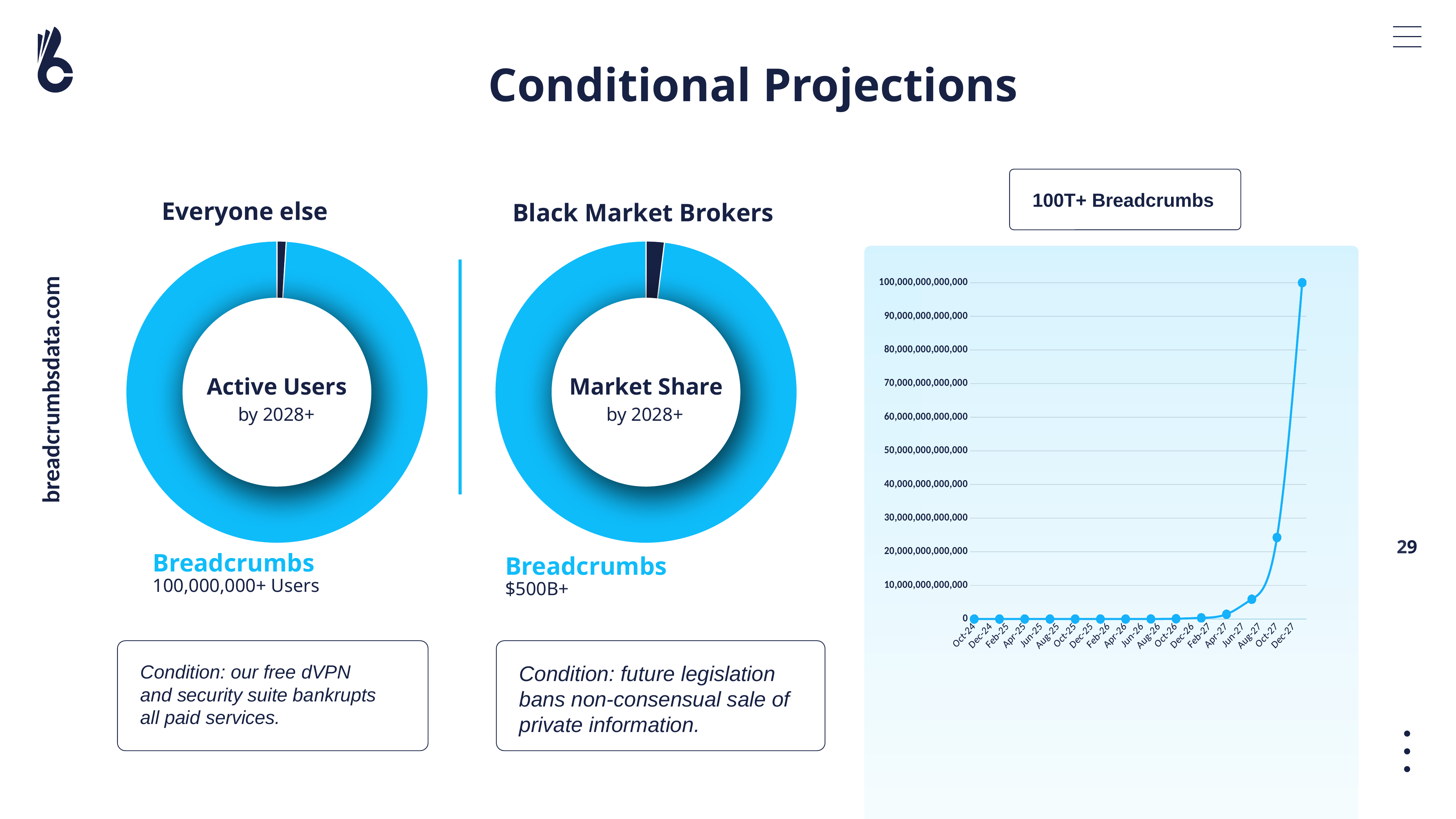
In the "100T+ Breadcrumbs" line chart, how many data points are plotted? 14 In the "Market Share by 2028+" donut chart, which slice is smaller, Breadcrumbs or Black Market Brokers? Black Market Brokers In the "100T+ Breadcrumbs" line chart, is the value for Oct-27 greater or less than 20,000,000,000,000? greater What kind of chart is the chart on the right titled "100T+ Breadcrumbs"? line chart What kind of chart is the "Active Users by 2028+" chart on the left? pie chart In the "Market Share by 2028+" donut chart, what value is printed for Breadcrumbs? $500B+ In the "Active Users by 2028+" donut chart, which slice is larger, Breadcrumbs or Everyone else? Breadcrumbs In the "100T+ Breadcrumbs" line chart, do the values rise or fall from Oct-24 to Dec-27? rise